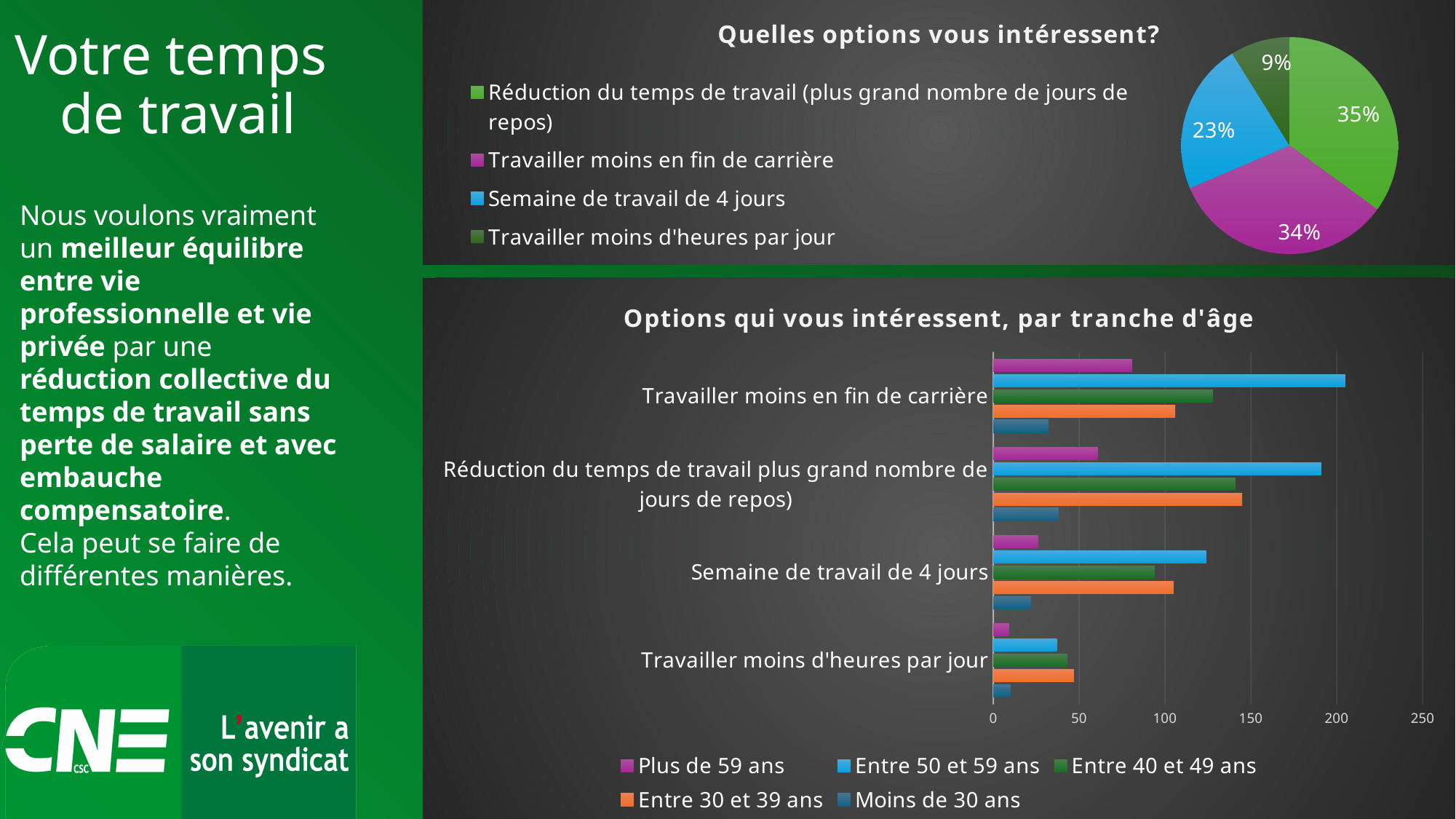
In the chart 'Options qui vous intéressent, par tranche d'âge', which age group has the lowest value for 'Travailler moins en fin de carrière'? Moins de 30 ans In the pie chart 'Quelles options vous intéressent?', which option has the smallest share? Travailler moins d'heures par jour In the chart 'Options qui vous intéressent, par tranche d'âge', is the value for 'Entre 50 et 59 ans' on 'Réduction du temps de travail plus grand nombre de jours de repos)' greater or less than 150? greater In the pie chart 'Quelles options vous intéressent?', what is the difference in percentage points between the largest and smallest slices? 26% In the pie chart 'Quelles options vous intéressent?', what share does 'Semaine de travail de 4 jours' have? 23% In the chart 'Options qui vous intéressent, par tranche d'âge', which age group has the highest value for 'Travailler moins en fin de carrière'? Entre 50 et 59 ans In the chart 'Options qui vous intéressent, par tranche d'âge', is the value for 'Entre 30 et 39 ans' on 'Travailler moins d'heures par jour' greater or less than 100? less In the pie chart 'Quelles options vous intéressent?', which option has the largest share? Réduction du temps de travail (plus grand nombre de jours de repos) In the chart 'Options qui vous intéressent, par tranche d'âge', how many series does the legend list? 5 In the chart 'Options qui vous intéressent, par tranche d'âge', for 'Travailler moins en fin de carrière', which is larger: 'Plus de 59 ans' or 'Moins de 30 ans'? Plus de 59 ans What kind of chart is 'Options qui vous intéressent, par tranche d'âge'? Bar chart In the pie chart 'Quelles options vous intéressent?', how many slices are there? 4